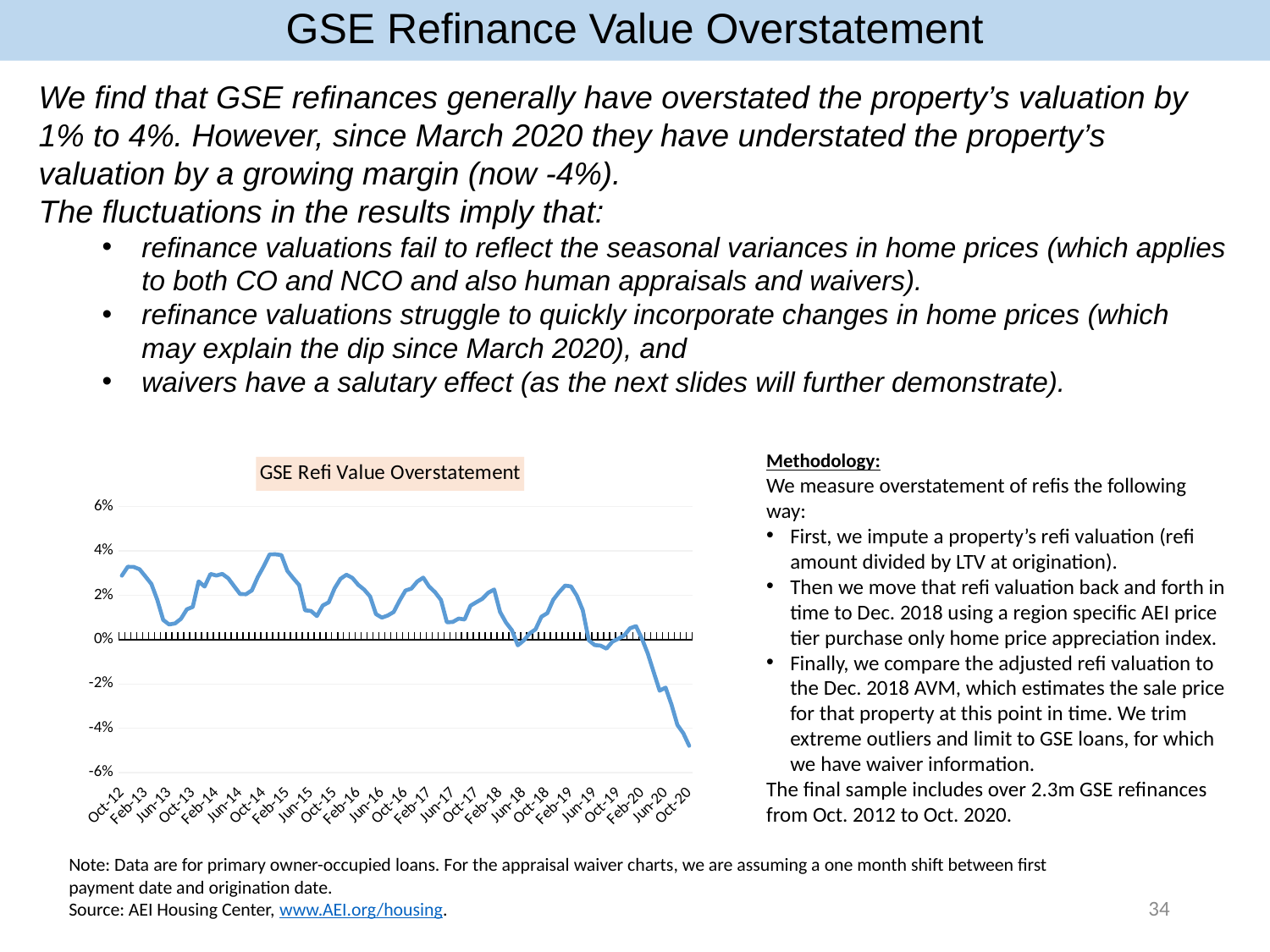
What is the title of the chart on the slide? GSE Refi Value Overstatement Is the value for Feb-15 greater or less than 2%? greater Which is larger, the value for Feb-15 or the value for Jun-13? Feb-15 Around which date does the line reach its lowest value? Oct-20 What kind of chart is shown on the slide? line chart What are the lowest and highest values shown on the y axis? -6% and 6% Is the value for Jun-20 greater or less than 0%? less Is the value for Oct-20 greater or less than -4%? less How many lines (series) are plotted in the chart? 1 Which is larger, the value for Oct-12 or the value for Oct-20? Oct-12 Do the values rise or fall between Feb-20 and Oct-20? fall